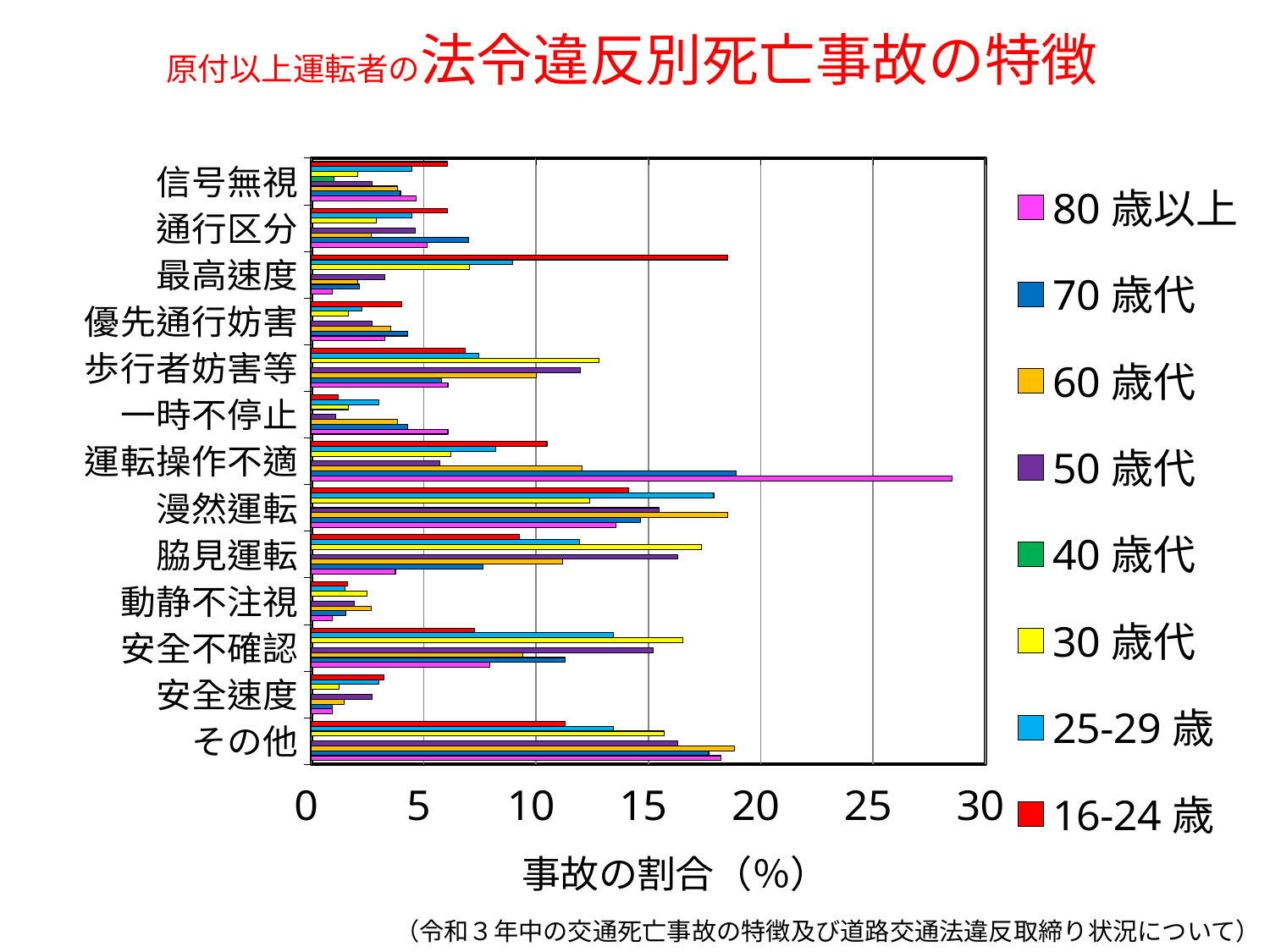
Is the value for 16-24 歳 in 安全速度 greater or less than 5? less For 最高速度, which is larger: the value for 16-24 歳 or the value for 80 歳以上? 16-24 歳 How many violation categories are listed on the vertical axis of the chart? 13 Which colour represents the 16-24 歳 series in the legend? red Which violation category contains the single longest bar in the chart? 運転操作不適 What kind of chart is shown on the slide? bar chart Is the value for 80 歳以上 in 運転操作不適 greater or less than 25? greater What is the title of the horizontal axis? 事故の割合（%） For 運転操作不適, which age group has the highest value? 80 歳以上 Is the value for 80 歳以上 in 動静不注視 greater or less than 5? less How many age-group series does the legend list? 8